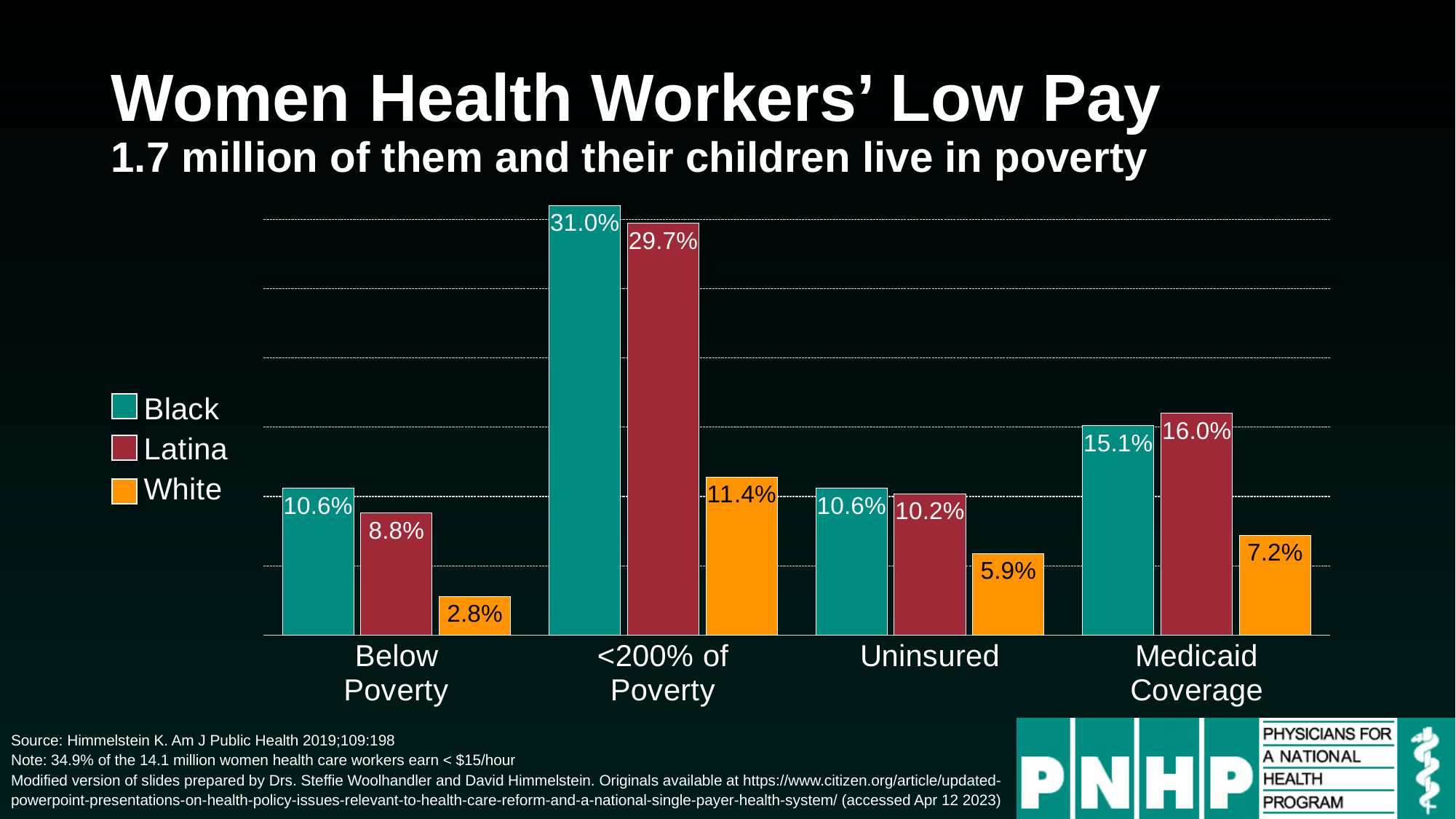
What is the value for Latina women health workers in the Medicaid Coverage category? 16.0% How many categories are shown on the x axis? 4 In the Medicaid Coverage category, which is larger, the Black value or the Latina value? Latina What kind of chart is shown on the slide? Bar chart What is the difference between the Black and Latina values in the <200% of Poverty category? 1.3% What is the value for White women health workers in the <200% of Poverty category? 11.4% Which category has the highest value for the Black series? <200% of Poverty Which colour represents the White series in the legend? Orange Which category has the lowest value for the White series? Below Poverty What is the value for White women health workers in the Uninsured category? 5.9% What is the value for Black women health workers in the Below Poverty category? 10.6% How many series does the legend list? 3